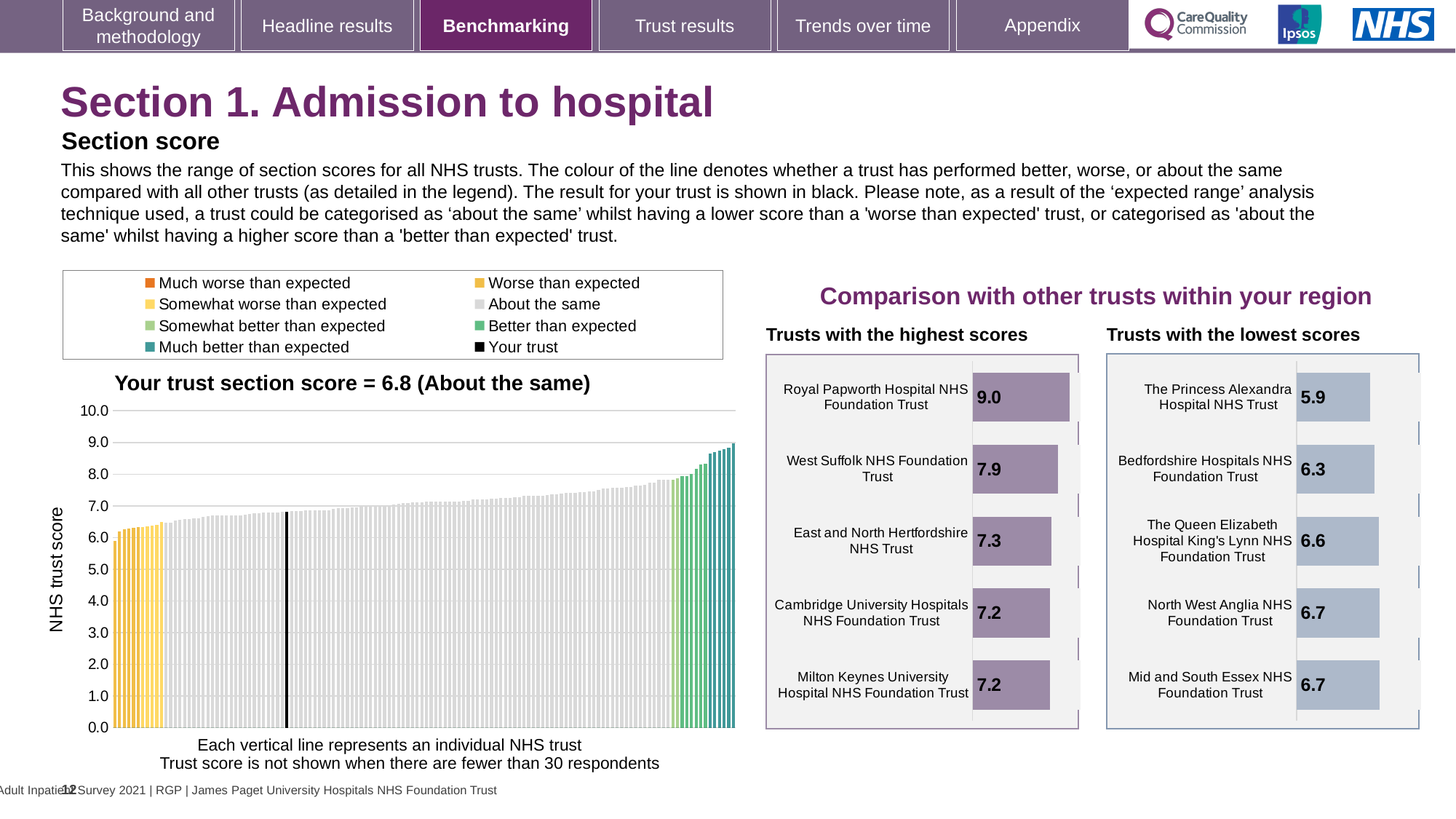
On the 'Trusts with the lowest scores' chart, what is the difference between the scores of Mid and South Essex NHS Foundation Trust and The Princess Alexandra Hospital NHS Trust? 0.8 What kind of chart is the 'Your trust section score' chart? bar chart On the 'Trusts with the lowest scores' chart, which has the larger score: Bedfordshire Hospitals NHS Foundation Trust or The Queen Elizabeth Hospital King's Lynn NHS Foundation Trust? The Queen Elizabeth Hospital King's Lynn NHS Foundation Trust On the 'Your trust section score' chart, is the value of the highest bar greater or less than 8.0? greater On the 'Your trust section score' chart, is the value of the lowest bar greater or less than 5.0? greater How many entries does the legend above the 'Your trust section score' chart list? 8 On the 'Your trust section score' chart, what is the section score for your trust? 6.8 On the 'Trusts with the highest scores' chart, how many trusts are shown? 5 On the 'Trusts with the highest scores' chart, what is the difference between the scores of Royal Papworth Hospital NHS Foundation Trust and West Suffolk NHS Foundation Trust? 1.1 What is the y-axis label on the 'Your trust section score' chart? NHS trust score On the 'Trusts with the highest scores' chart, what is the score for Royal Papworth Hospital NHS Foundation Trust? 9.0 On the 'Trusts with the lowest scores' chart, which trust has the lowest score? The Princess Alexandra Hospital NHS Trust